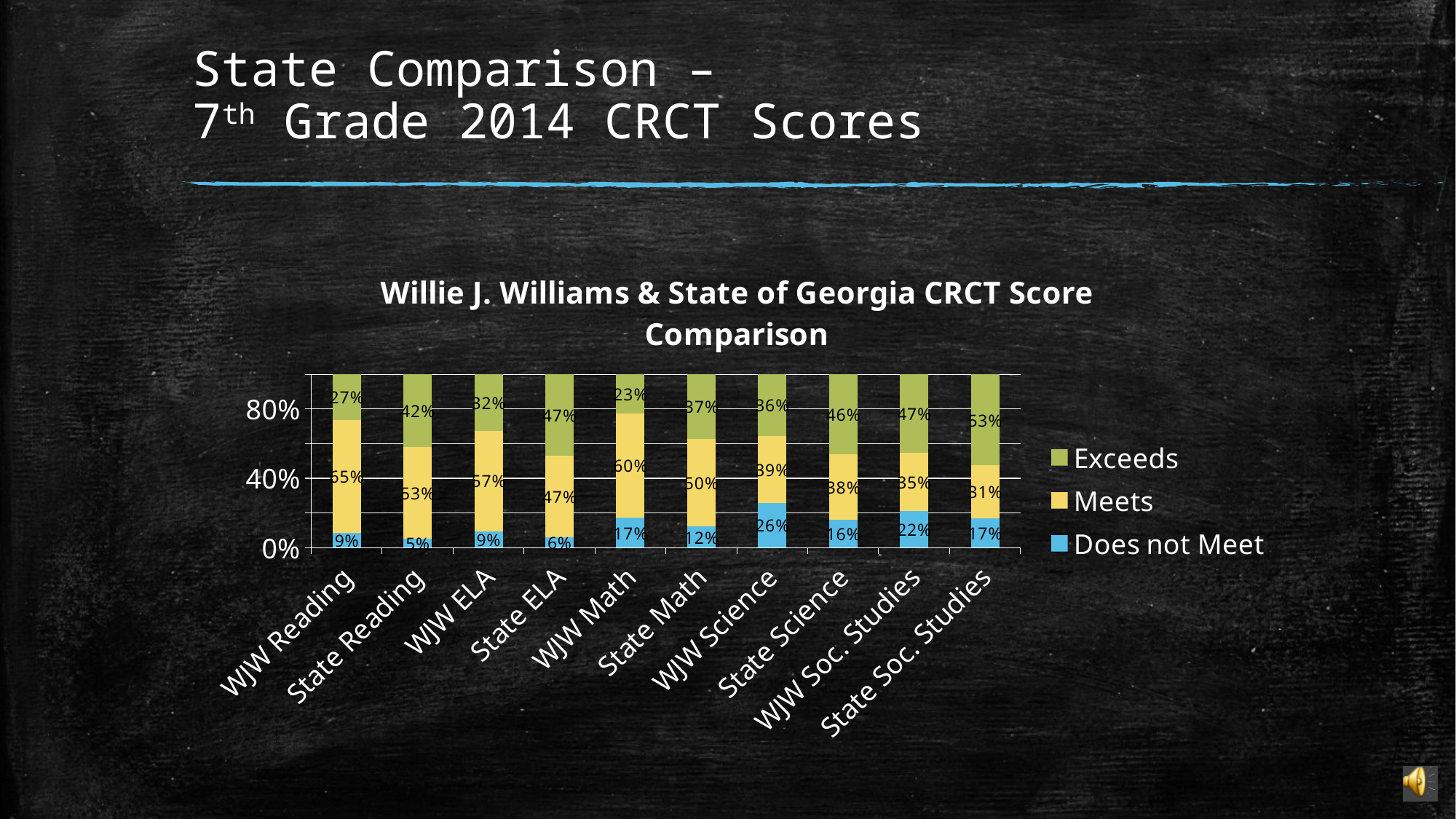
How much higher is the Exceeds percentage for State Reading than for WJW Reading? 15% What is the Meets percentage for WJW Reading? 65% Which category has the lowest Does not Meet percentage? State Reading Which has a larger Meets percentage, WJW Math or State Math? WJW Math What is the Does not Meet percentage for WJW Science? 26% Which category has the highest Exceeds percentage? State Soc. Studies How many series does the legend list? 3 What is the difference between the Does not Meet percentages for WJW Soc. Studies and State Soc. Studies? 5% What is the Exceeds percentage for State Soc. Studies? 53% How many categories are shown on the x axis? 10 Which category has the highest Meets percentage? WJW Reading What kind of chart is shown on the slide? Stacked bar chart